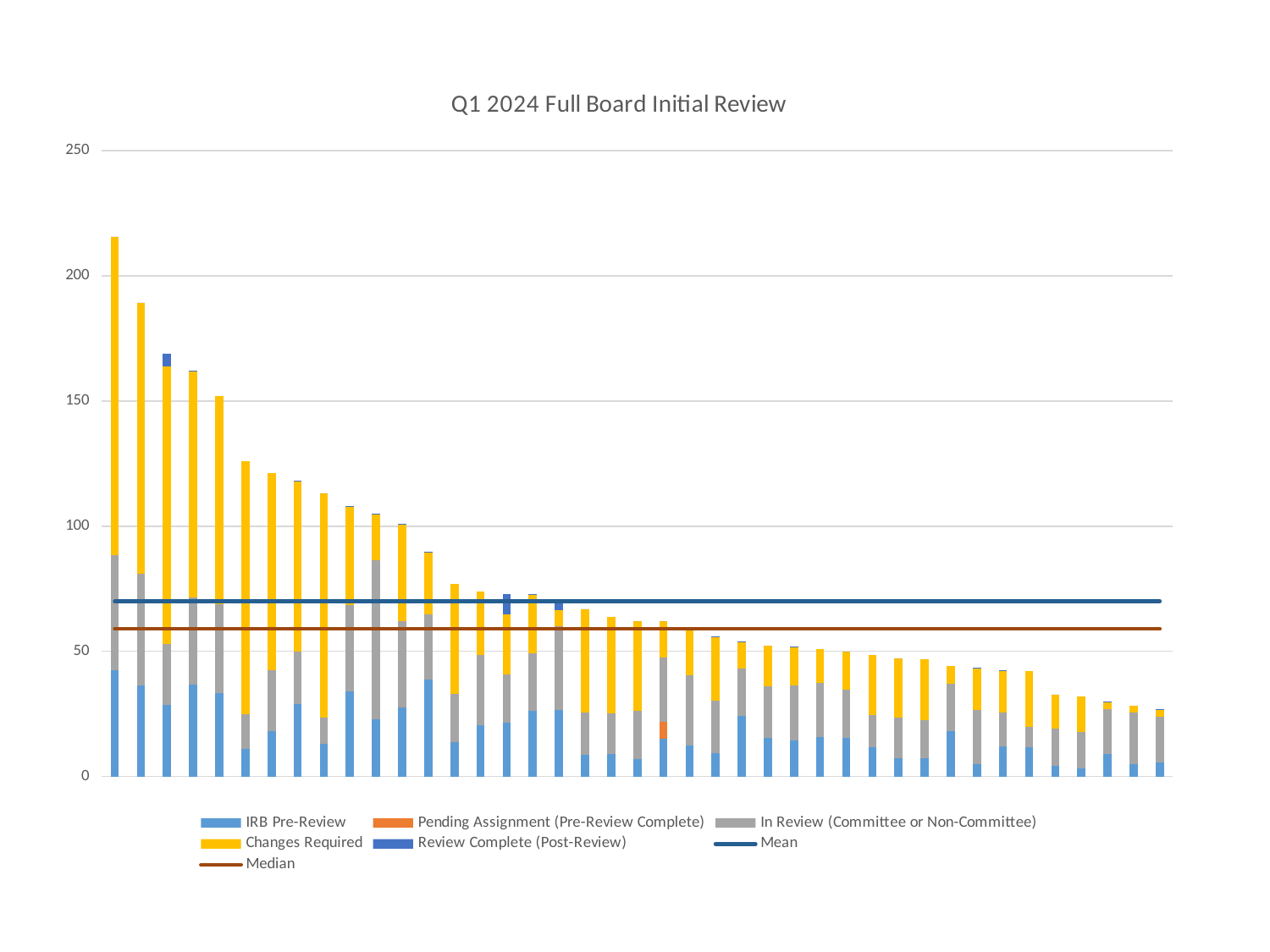
Is the Median line greater or less than 100? less Is the total of the leftmost bar greater or less than 200? greater Is the total of the rightmost bar greater or less than 50? less What is the title of the chart? Q1 2024 Full Board Initial Review Which colour represents the Changes Required series? Yellow How many entries does the chart's legend list? 7 Which bar has the highest total? The leftmost bar Do the bar totals rise or fall from left to right along the x axis? Fall Which horizontal line sits higher on the chart, Mean or Median? Mean What kind of chart is shown on the slide? Stacked bar chart